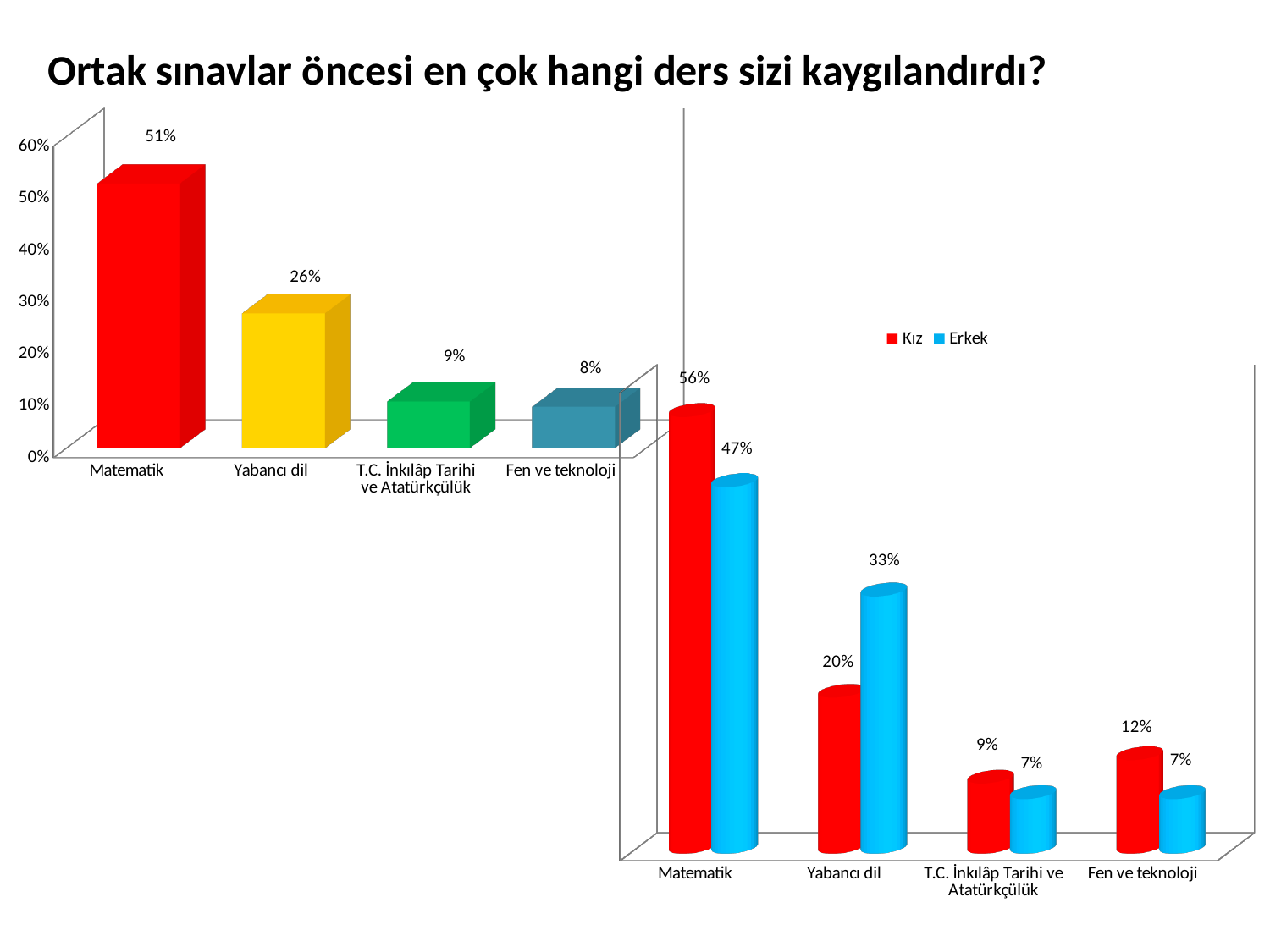
In the bottom-right chart, which category has the highest Kız value? Matematik In the bottom-right chart, how many series does the legend list? 2 What kind of chart is the top-left chart? Bar chart In the top-left chart, what is the value for Yabancı dil? 26% In the bottom-right chart, what is the difference between Kız and Erkek for Fen ve teknoloji? 5% In the top-left chart, which category has the lowest value? Fen ve teknoloji In the top-left chart, how many categories are shown? 4 In the top-left chart, what is the difference between Matematik and Yabancı dil? 25% In the bottom-right chart, what is the Erkek value for Yabancı dil? 33% In the bottom-right chart, which is larger for Yabancı dil, Kız or Erkek? Erkek In the bottom-right chart, what is the Kız value for Matematik? 56% In the top-left chart, what is the value for Matematik? 51%